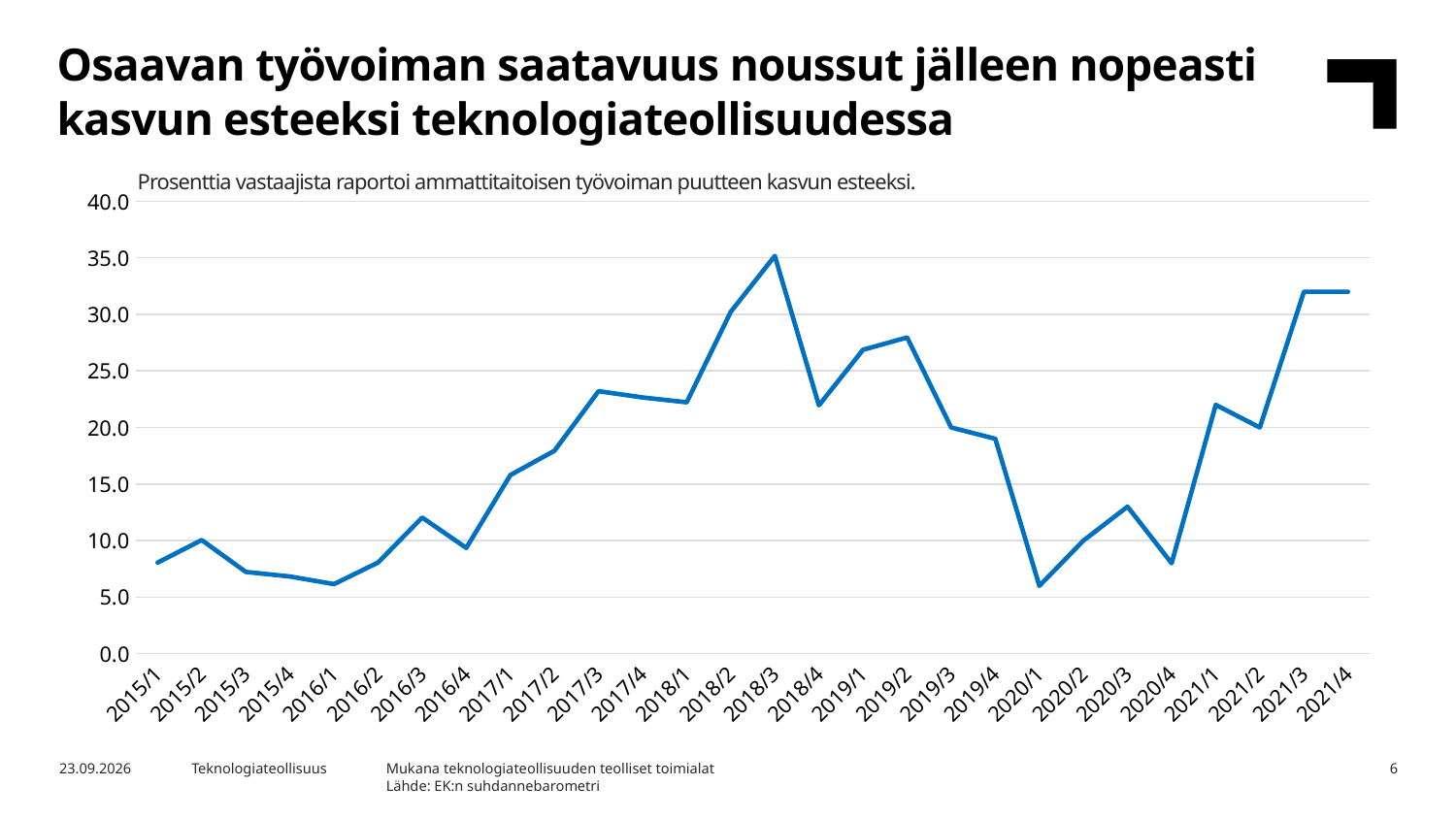
Is the value for 2021/4 greater or less than 30.0? greater Is the value for 2019/2 greater or less than 25.0? greater Do the values rise or fall from 2019/2 to 2020/1? fall Is the value for 2016/1 greater or less than 10.0? less How many quarters are plotted along the x axis? 28 Which is larger, the value for 2018/3 or the value for 2021/3? 2018/3 What kind of chart is shown on the slide? line chart Which quarter has the highest value on the chart? 2018/3 Which is larger, the value for 2017/3 or the value for 2017/1? 2017/3 What is the subtitle text shown above the chart? Prosenttia vastaajista raportoi ammattitaitoisen työvoiman puutteen kasvun esteeksi.